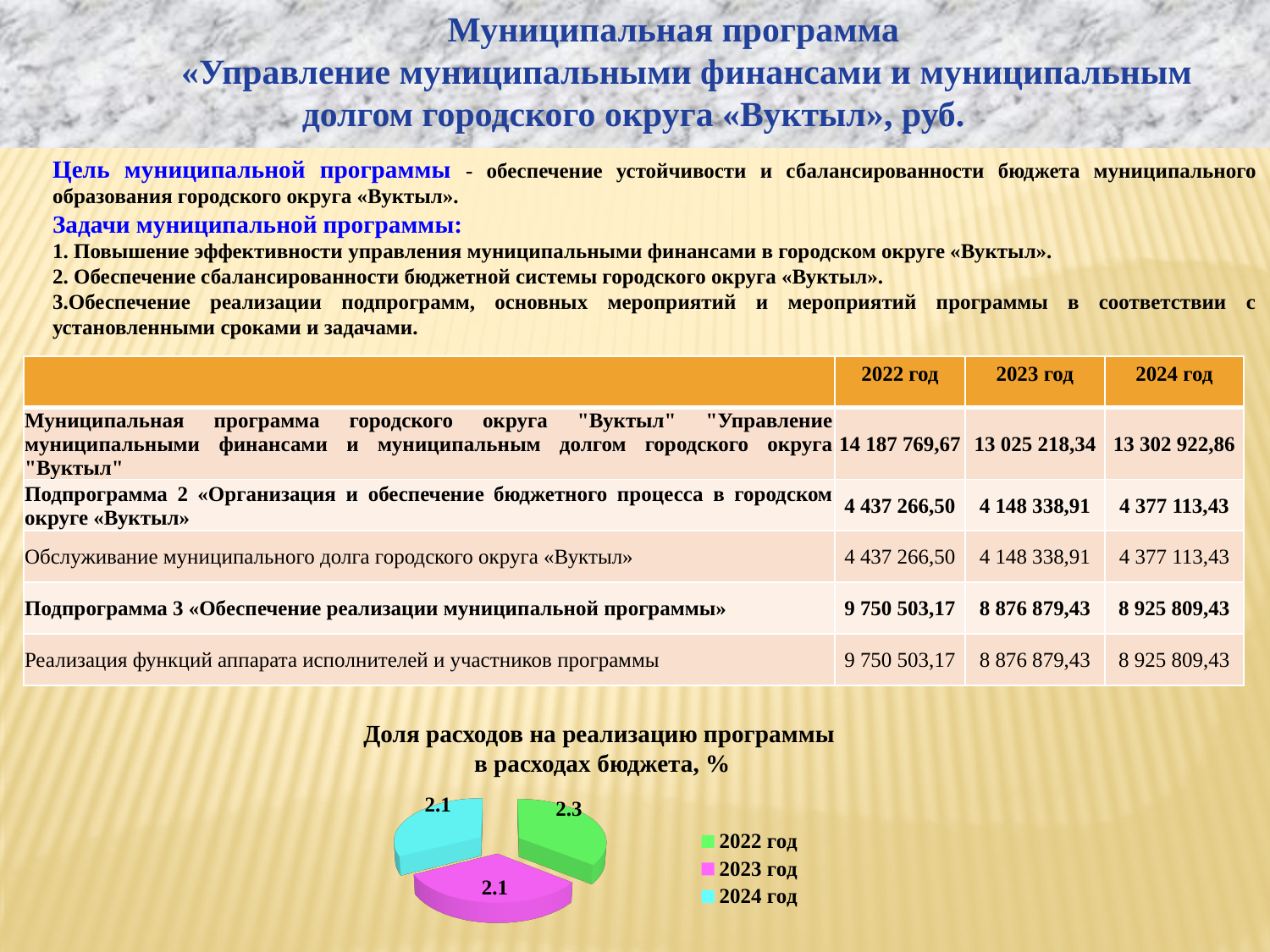
What is the title of the pie chart? Доля расходов на реализацию программы в расходах бюджета, % How many entries does the legend of the pie chart list? 3 What is the value for 2024 год in the pie chart? 2.1 What is the value for 2023 год in the pie chart? 2.1 Which is larger in the pie chart, the value for 2022 год or for 2023 год? 2022 год What kind of chart is shown at the bottom of the slide? Pie chart What is the value for 2022 год in the pie chart? 2.3 Which colour represents 2023 год in the pie chart? Pink What is the difference between the values for 2022 год and 2024 год in the pie chart? 0.2 Which year has the largest slice in the pie chart? 2022 год How many slices does the pie chart have? 3